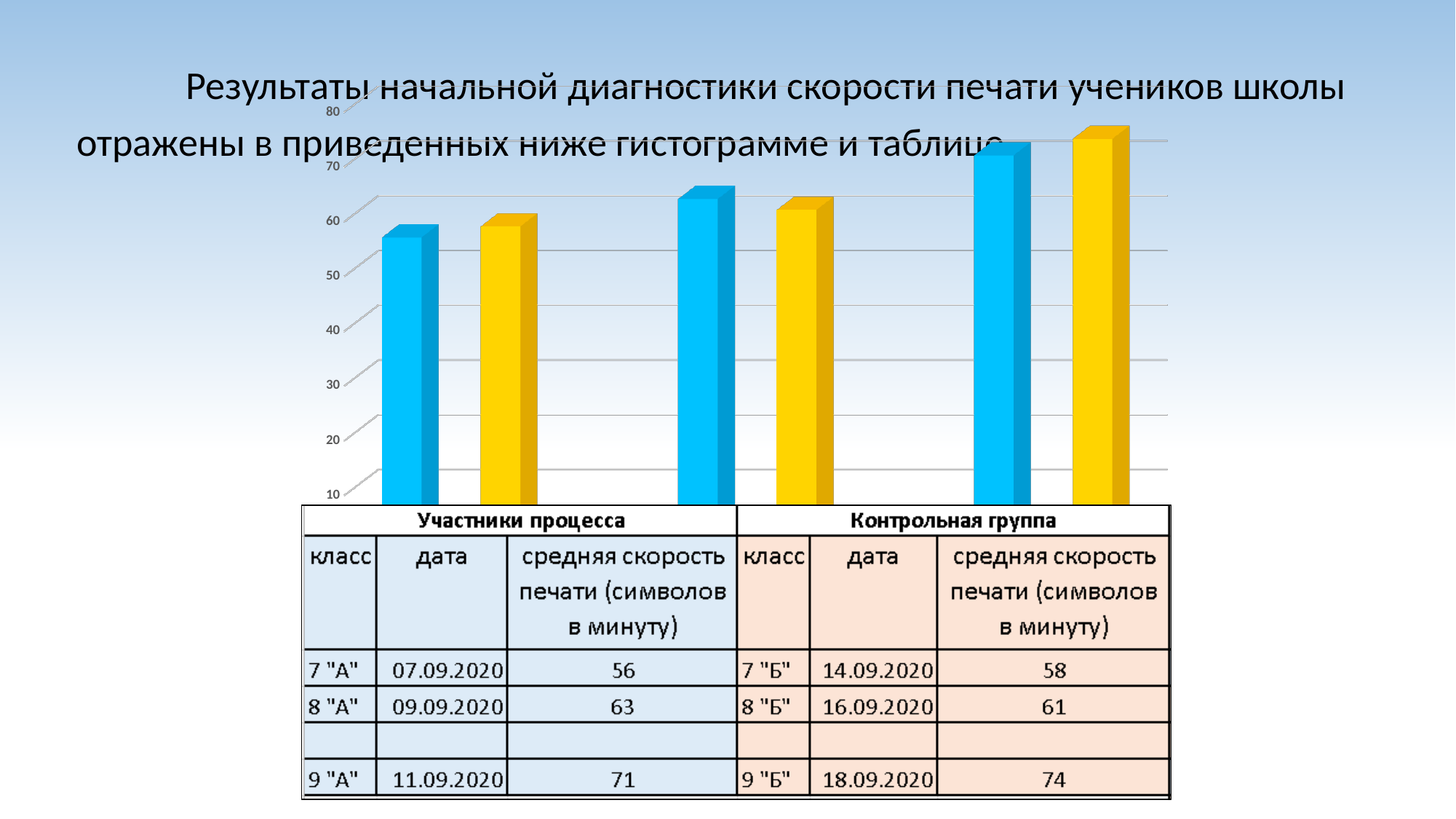
What kind of chart is shown on the slide? bar chart Which bar is the tallest in the chart? the rightmost yellow bar Is the value of the leftmost blue bar greater or less than 50? greater What is the highest value shown on the chart's vertical axis? 80 Is the value of the rightmost yellow bar greater or less than 70? greater Is the value of the third bar from the left (blue) greater or less than 60? greater Do the bar heights generally rise or fall from left to right across the chart? rise What two colours are used for the bars in the chart? blue and yellow How many bars are plotted in the chart? 6 Which is taller: the first bar from the left or the third bar from the left? the third bar from the left Which is taller: the leftmost blue bar or the rightmost yellow bar? the rightmost yellow bar